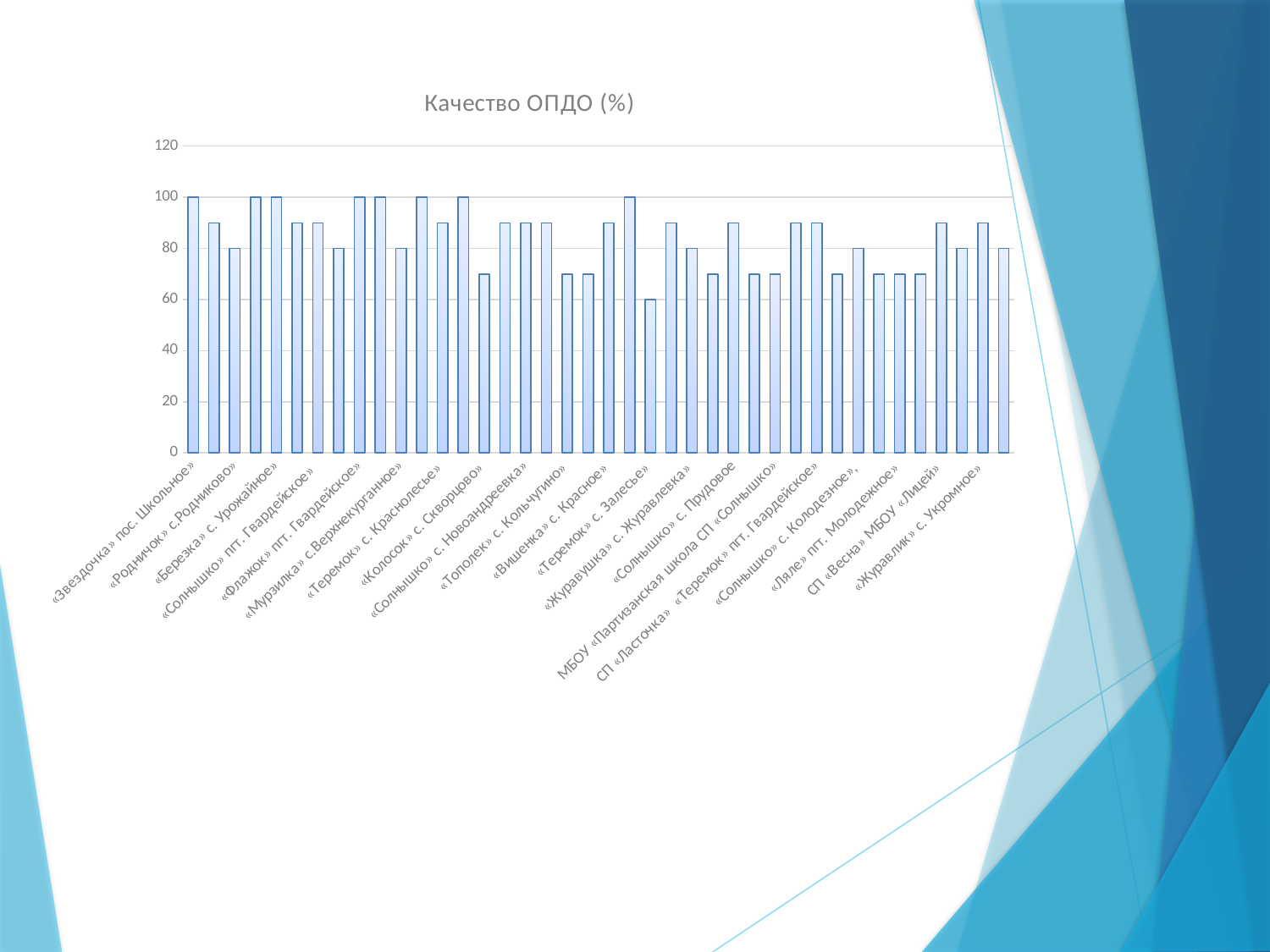
What is the maximum value shown on the vertical axis? 120 Is the value for «Теремок» с. Залесье greater or less than 40? greater What is the highest value reached by any bar in the chart? 100 Is the value for МБОУ «Партизанская школа СП «Солнышко» greater or less than 100? less Is the value for «Тополек» с. Кольчугино greater or less than 100? less What is the title of the chart? Качество ОПДО (%) What is the lowest value reached by any bar in the chart? 60 What type of chart is shown on the slide? bar chart